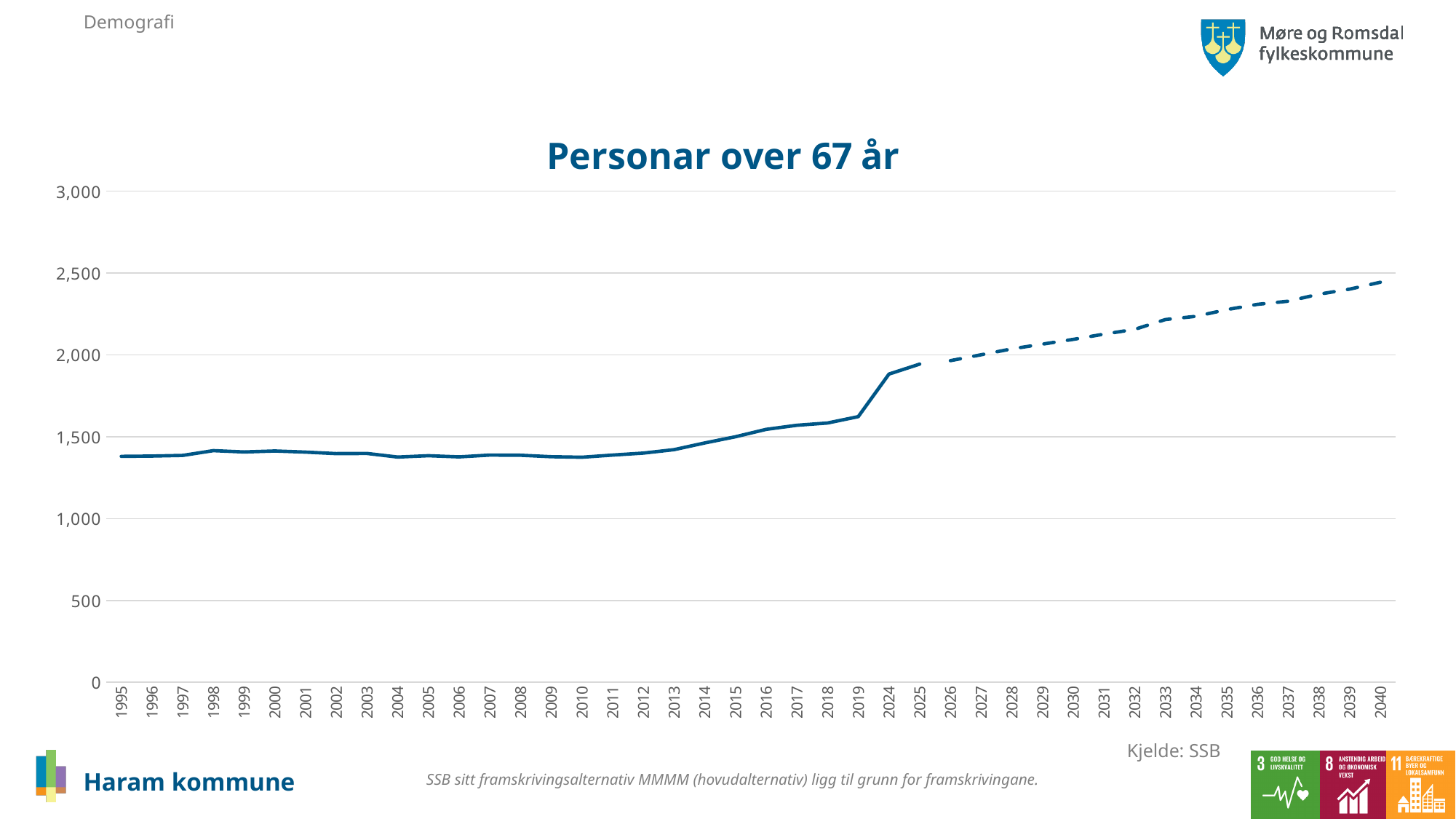
Is the value for 1995 greater or less than 1,500? less Which year has the highest value in the chart? 2040 Is the value for 2024 greater or less than 1,500? greater Which is larger, the value for 2024 or the value for 2019? 2024 Is the value for 2033 greater or less than 2,000? greater What is the title of the chart? Personar over 67 år Do the values generally rise or fall from 2013 to 2040? rise What source is cited below the chart? SSB What kind of chart is shown on the slide? line chart Which is larger, the value for 1995 or the value for 2040? 2040